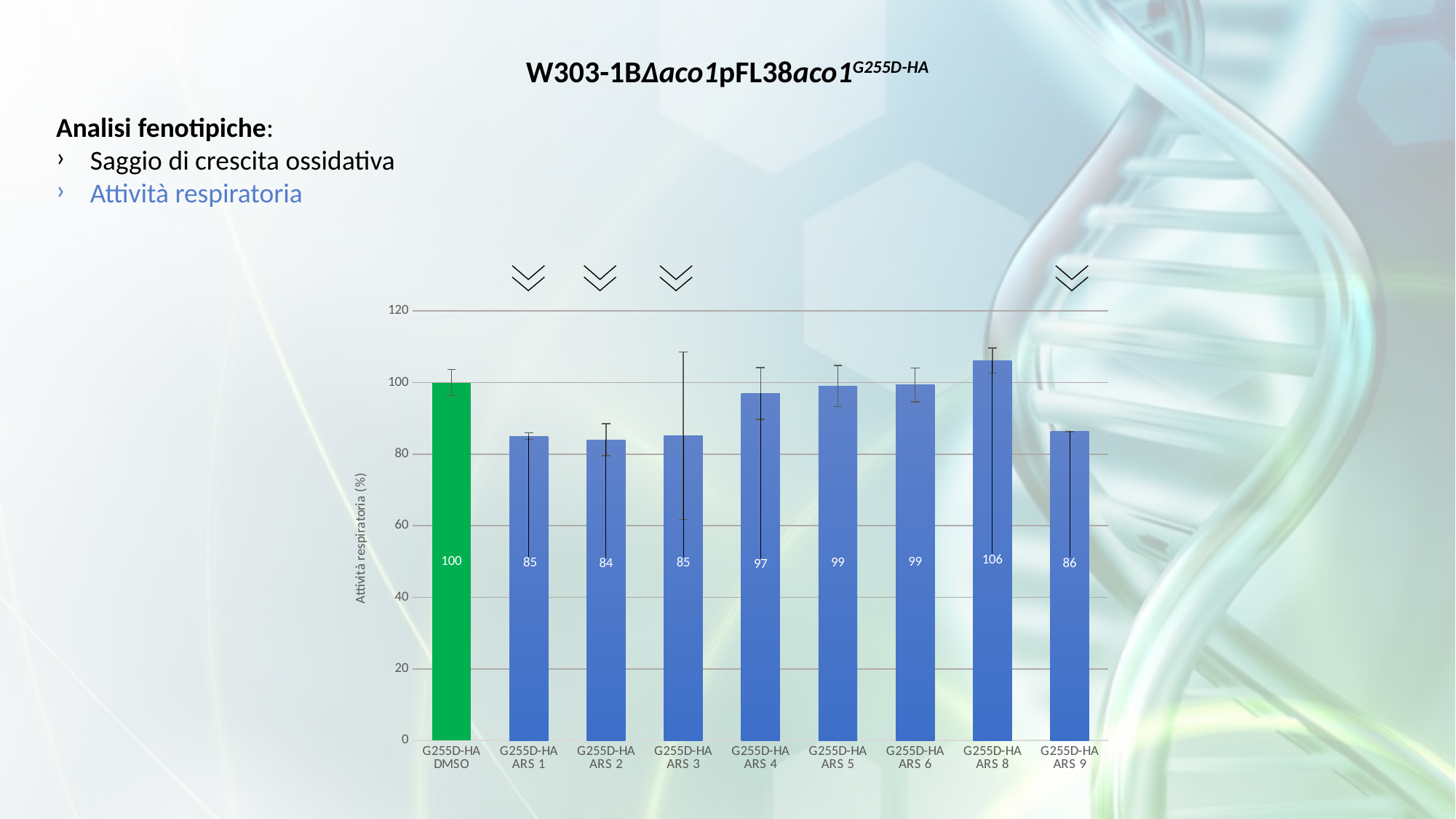
What kind of chart is shown on the slide? bar chart Which bar is coloured green rather than blue? G255D-HA DMSO Is the value for G255D-HA ARS 8 greater or less than 100? greater Which is larger, the value for G255D-HA ARS 4 or G255D-HA ARS 9? G255D-HA ARS 4 Which category has the highest value? G255D-HA ARS 8 What is the value for G255D-HA DMSO? 100 Which category has the lowest value? G255D-HA ARS 2 What is the label of the y axis? Attività respiratoria (%) How many categories are shown on the x axis? 9 What is the value for G255D-HA ARS 8? 106 What is the value for G255D-HA ARS 2? 84 What is the difference between the values for G255D-HA DMSO and G255D-HA ARS 1? 15